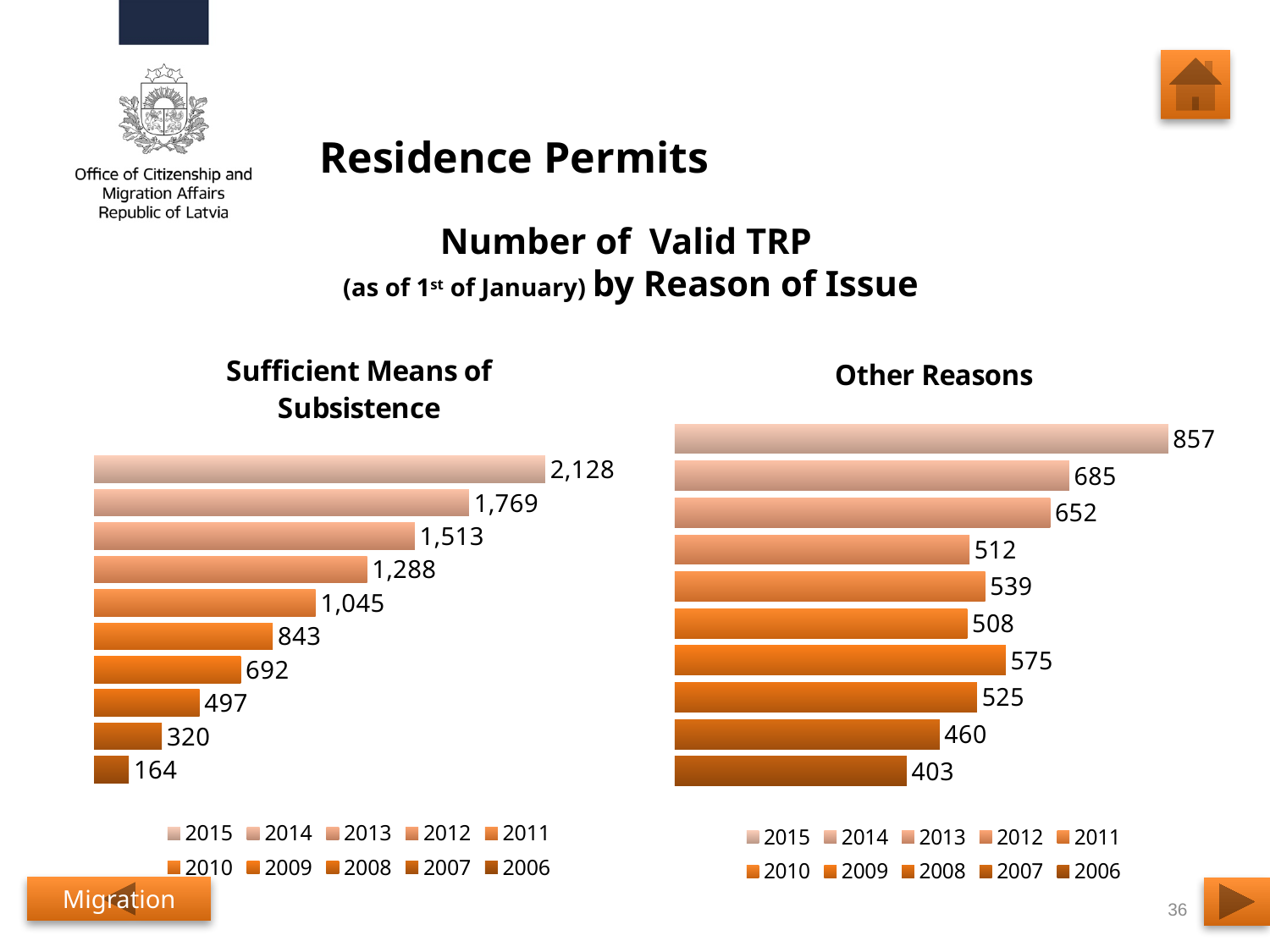
In the 'Sufficient Means of Subsistence' chart, what is the value for 2015 (the lightest, top bar)? 2,128 In the 'Other Reasons' chart, what is the difference between the top bar (857) and the second bar (685)? 172 In the 'Sufficient Means of Subsistence' chart, what is the value of the longest bar? 2,128 Which is larger: the longest bar in the 'Sufficient Means of Subsistence' chart or the longest bar in the 'Other Reasons' chart? Sufficient Means of Subsistence How many bars are shown in the 'Other Reasons' chart? 10 In the 'Other Reasons' chart, what is the value of the longest bar? 857 How many entries does the legend of the 'Sufficient Means of Subsistence' chart list? 10 In the 'Sufficient Means of Subsistence' chart, what is the value of the shortest bar? 164 What type of chart is the 'Other Reasons' chart? Bar chart In the 'Other Reasons' chart, what is the value of the shortest bar? 403 In the 'Other Reasons' chart, what is the value for 2006 (the darkest, bottom bar)? 403 In the 'Sufficient Means of Subsistence' chart, what is the difference between the top bar (2,128) and the second bar (1,769)? 359